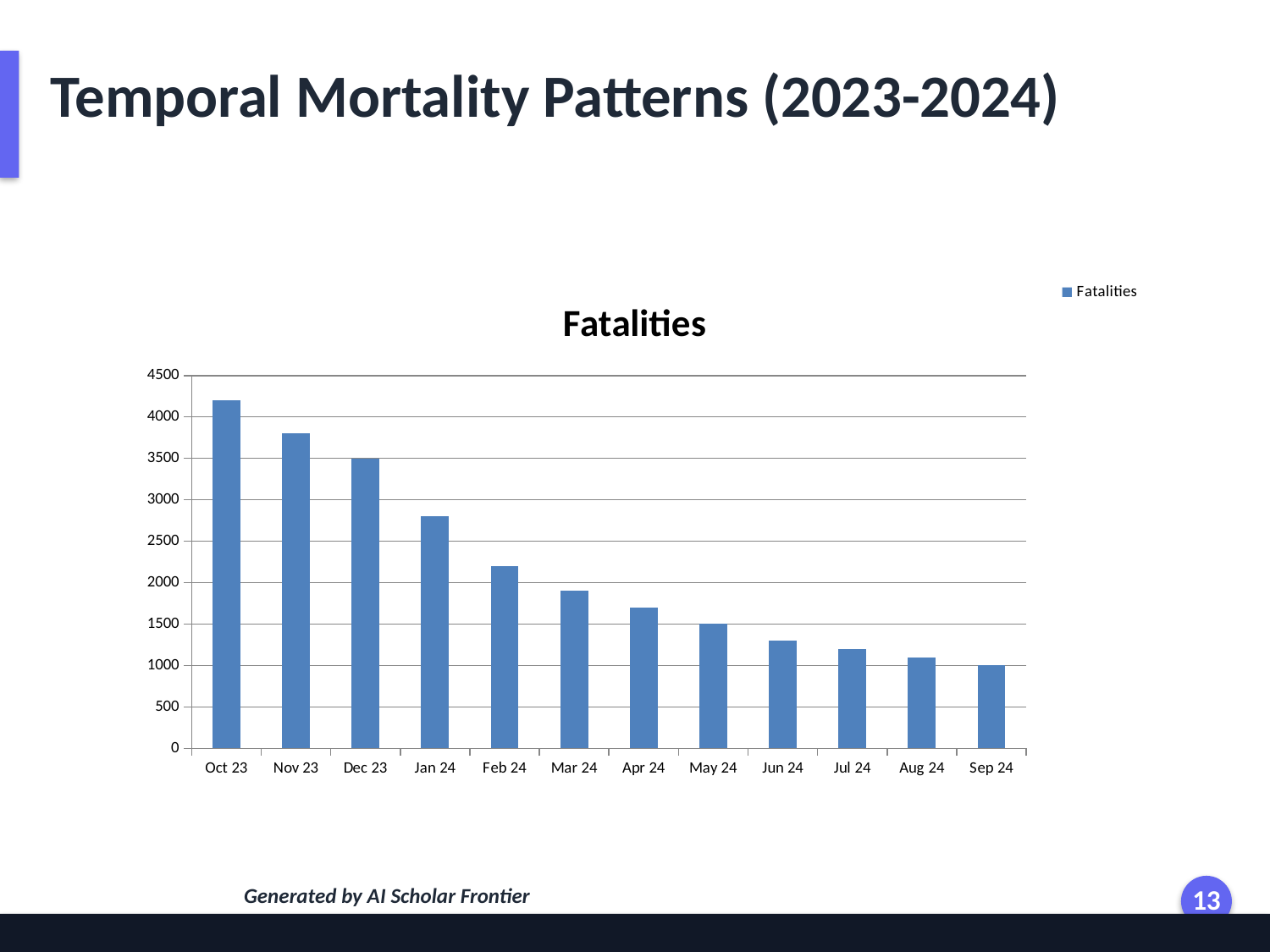
Which month has the highest number of fatalities? Oct 23 How many months are plotted on the x axis of the Fatalities chart? 12 What is the value for Dec 23 in the Fatalities chart? 3500 Is the value for Oct 23 greater or less than 4000? greater What is the value for May 24 in the Fatalities chart? 1500 How many series does the legend of the Fatalities chart list? 1 What type of chart is shown on the slide? bar chart Is the value for Jan 24 greater or less than 3000? less Which is larger, the value for Feb 24 or the value for Apr 24? Feb 24 Do the fatalities rise or fall from Oct 23 to Sep 24? fall What is the value for Sep 24 in the Fatalities chart? 1000 Which month has the lowest number of fatalities? Sep 24